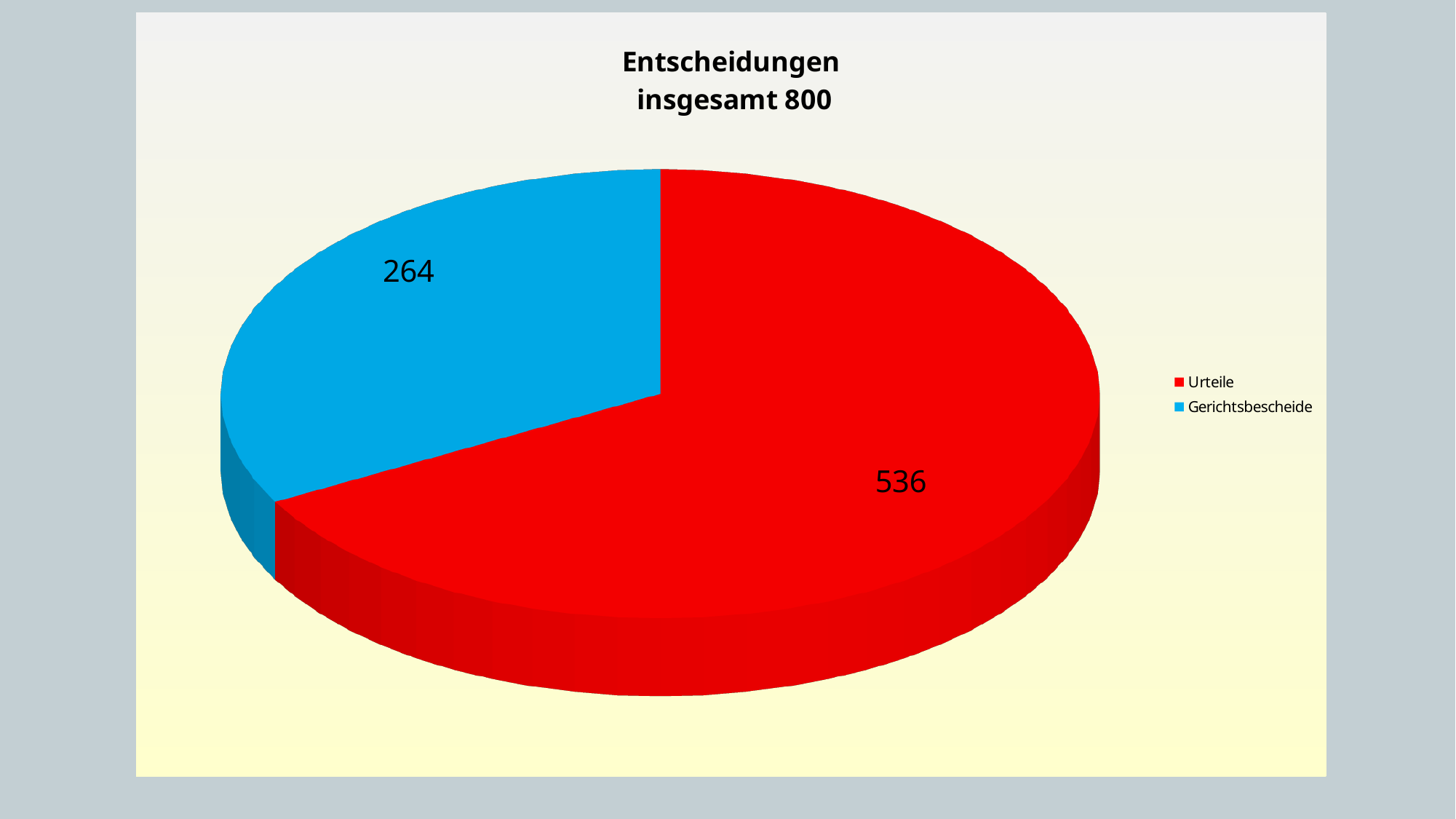
What is the value for Urteile? 536 What is the difference between the values for Urteile and Gerichtsbescheide? 272 What is the value for Gerichtsbescheide? 264 How many slices does the pie chart have? 2 Which is larger, Urteile or Gerichtsbescheide? Urteile How many entries does the legend list? 2 Which category has the smallest slice? Gerichtsbescheide What share of the pie does Urteile represent? 67% What is the total of the two slices? 800 Which category has the largest slice? Urteile What kind of chart is shown on the slide? pie chart What is the title of the chart? Entscheidungen insgesamt 800